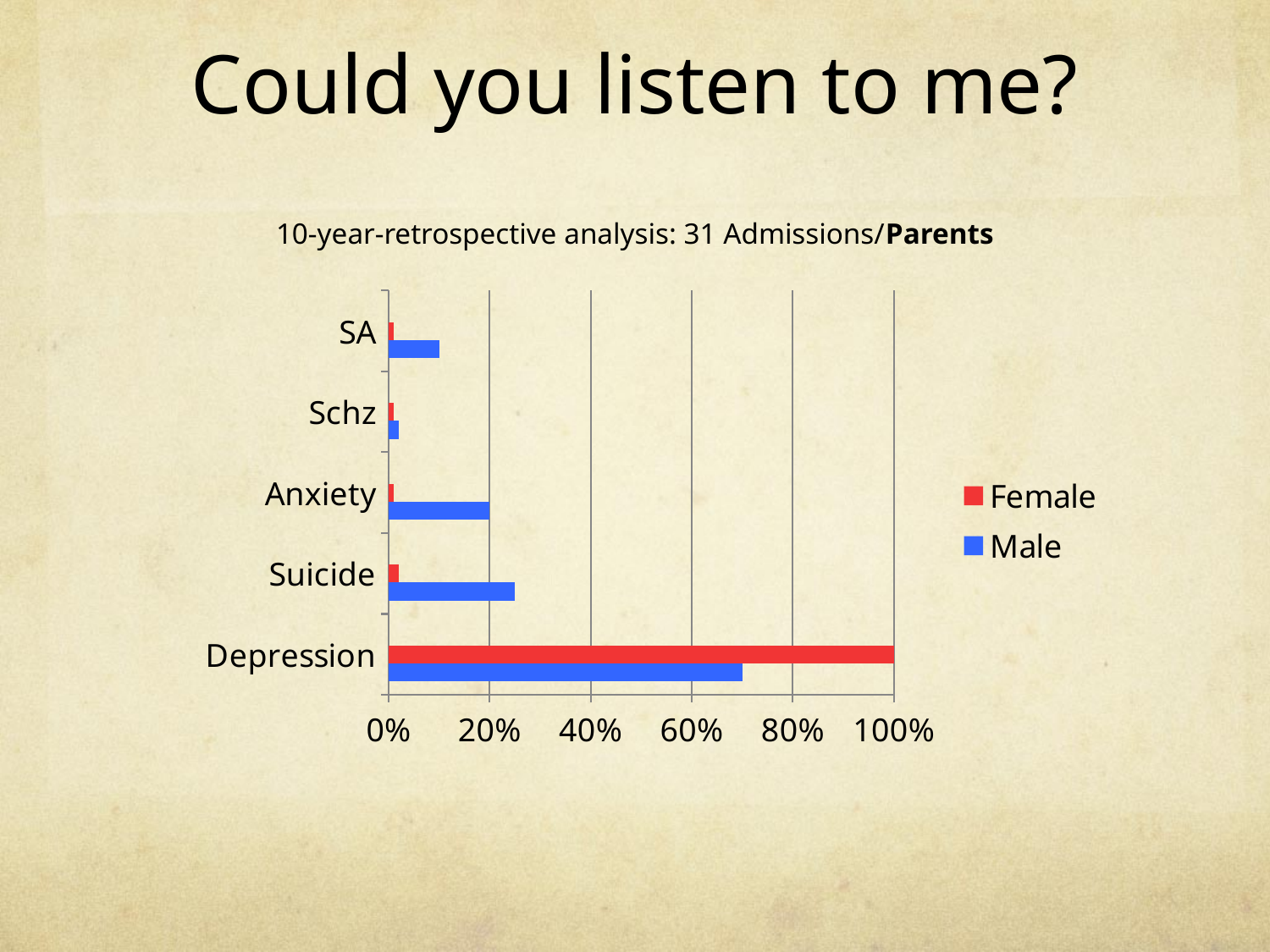
What is the Female value for Depression? 100% What kind of chart is shown on the slide? bar chart Is the Male value for Depression greater or less than 80%? less Is the Male value for Suicide greater or less than 20%? greater How many categories are shown on the vertical axis of the chart? 5 How many series does the legend list? 2 Which category has the highest Male value? Depression Is the Male value for Depression greater or less than 60%? greater Which category has the highest Female value? Depression What is the title of the chart? 10-year-retrospective analysis: 31 Admissions/Parents For Depression, which is larger, the Female value or the Male value? Female